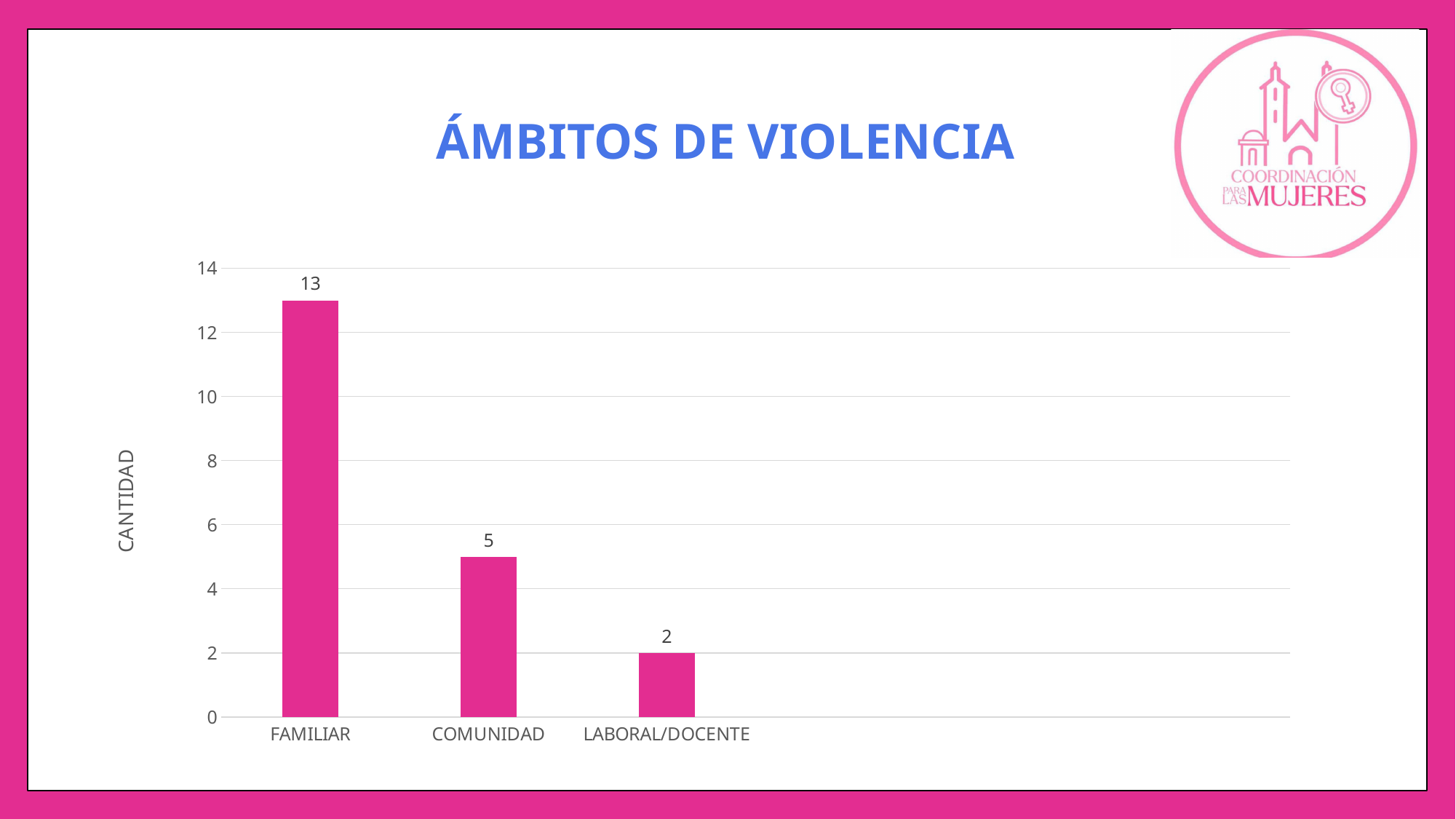
How many categories are shown on the x axis? 3 What is the value for LABORAL/DOCENTE? 2 What is the value for COMUNIDAD? 5 Is the value for FAMILIAR greater or less than 10? greater What is the value for FAMILIAR? 13 Which category has the highest value? FAMILIAR What is the difference between the values for COMUNIDAD and LABORAL/DOCENTE? 3 What is the difference between the values for FAMILIAR and COMUNIDAD? 8 Which is larger, the value for COMUNIDAD or the value for LABORAL/DOCENTE? COMUNIDAD What is the title of the chart? ÁMBITOS DE VIOLENCIA What kind of chart is shown on the slide? bar chart Which category has the lowest value? LABORAL/DOCENTE